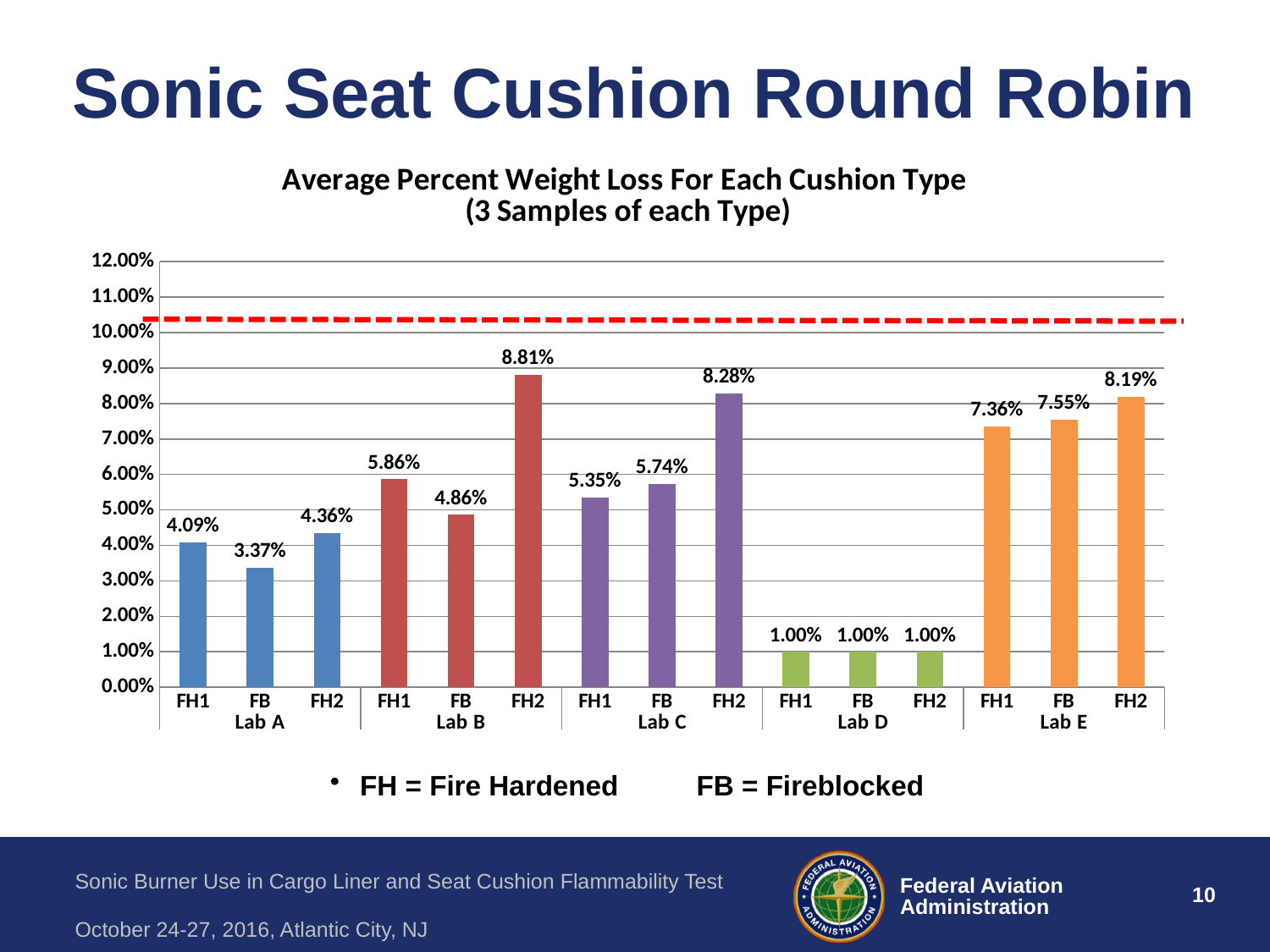
Within Lab E, do the values rise or fall from FH1 to FH2? Rise Which is larger, the FB value in Lab E or the FB value in Lab C? FB in Lab E Is the value for FH1 in Lab B greater or less than 5.00%? greater Which lab and cushion type has the highest average percent weight loss? Lab B FH2 What kind of chart is shown on the slide? Bar chart What is the average percent weight loss for FH2 in Lab B? 8.81% What is the difference between the FH2 and FH1 values in Lab C? 2.93% What is the title of the chart? Average Percent Weight Loss For Each Cushion Type (3 Samples of each Type) What is the average percent weight loss for FH1 in Lab E? 7.36% What is the average percent weight loss for FB in Lab A? 3.37% How many bars are plotted in the chart? 15 Which lab shows the lowest average percent weight loss values? Lab D